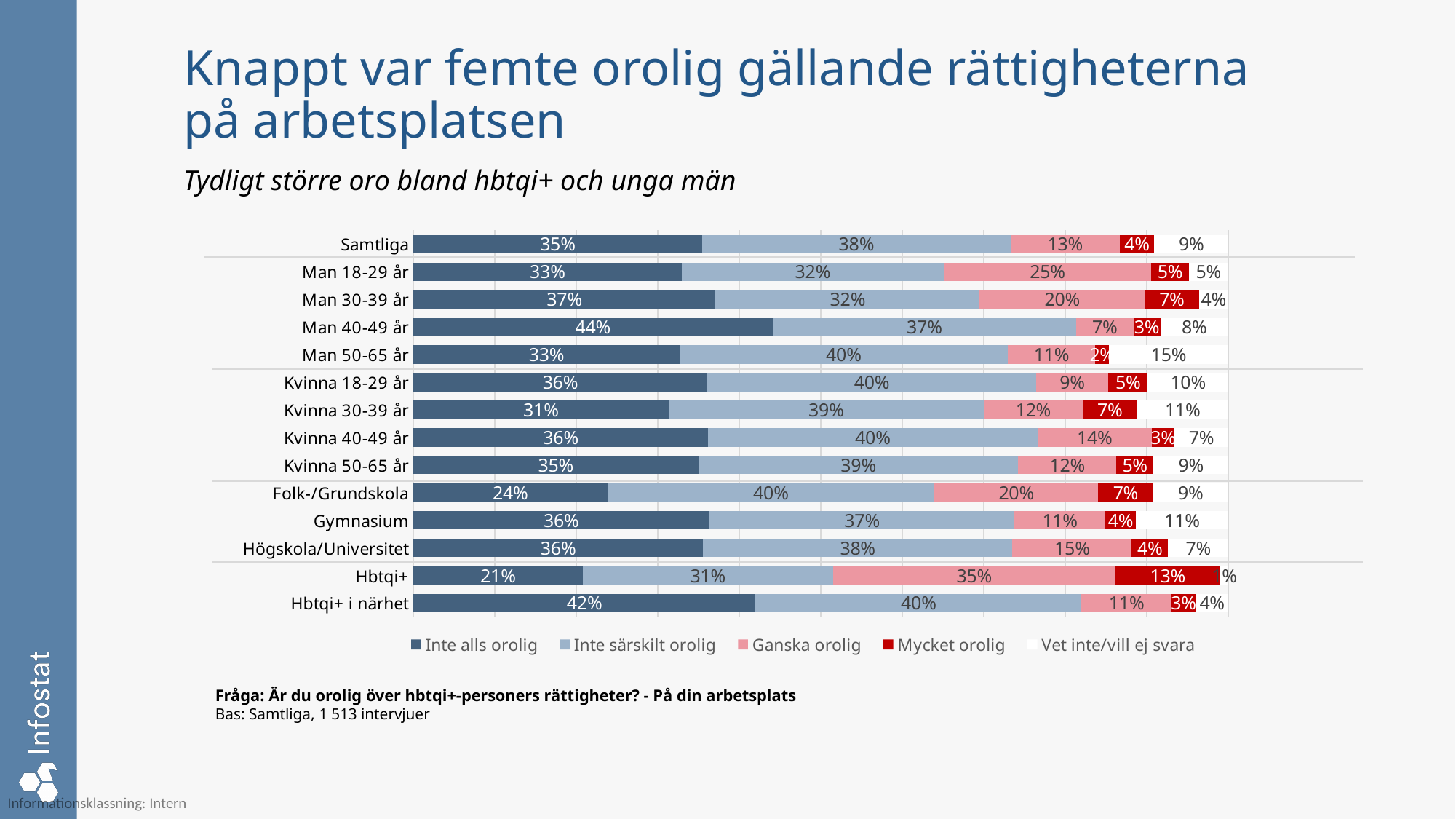
Which category has the lowest "Inte alls orolig" value? Hbtqi+ How many categories (rows) are shown in the chart? 14 Which has the larger "Inte särskilt orolig" value, Man 50-65 år or Man 18-29 år? Man 50-65 år How many series does the legend list? 5 What percentage of Samtliga answered "Inte alls orolig"? 35% What share of Man 18-29 år answered "Ganska orolig"? 25% How many percentage points higher is the "Ganska orolig" value for Hbtqi+ than for Samtliga? 22 percentage points What is the "Mycket orolig" value for Hbtqi+? 13% Which category has the highest "Mycket orolig" value? Hbtqi+ What type of chart is shown on the slide? Stacked bar chart Which category has the highest "Inte alls orolig" value? Man 40-49 år What is the "Vet inte/vill ej svara" value for Man 50-65 år? 15%